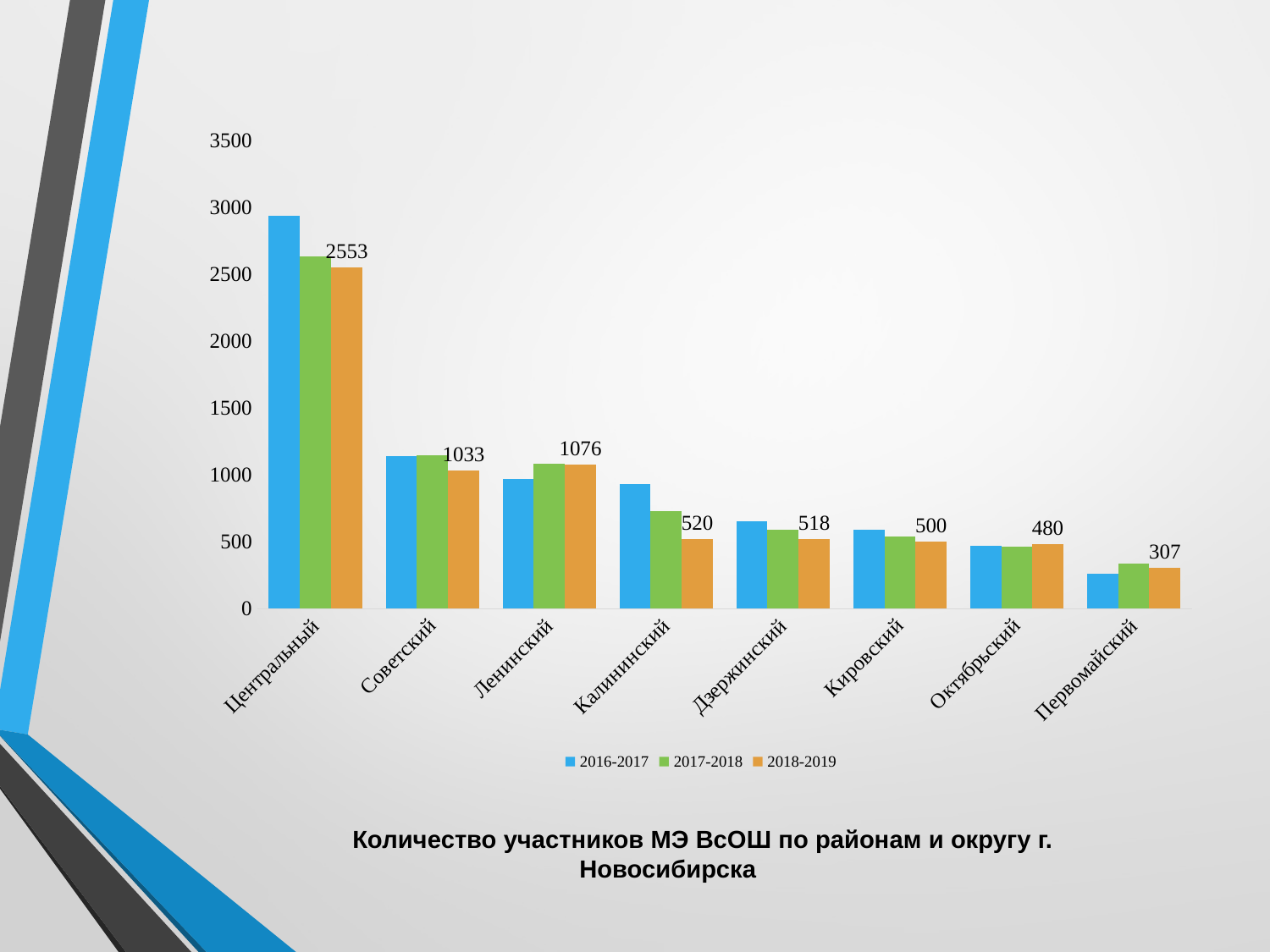
How many series does the legend list? 3 What is the value for Первомайский in the 2018-2019 series? 307 Which district has the lowest value in the 2018-2019 series? Первомайский What is the difference between the 2018-2019 values for Ленинский and Советский? 43 In the 2018-2019 series, which is larger: Дзержинский or Кировский? Дзержинский How many districts are shown on the x axis? 8 Is the 2016-2017 value for Центральный greater or less than 2500? greater What is the value for Ленинский in the 2018-2019 series? 1076 Is the 2017-2018 value for Первомайский greater or less than 500? less What is the value for Центральный in the 2018-2019 series? 2553 What kind of chart is shown on the slide? Bar chart Which district has the highest value in the 2018-2019 series? Центральный